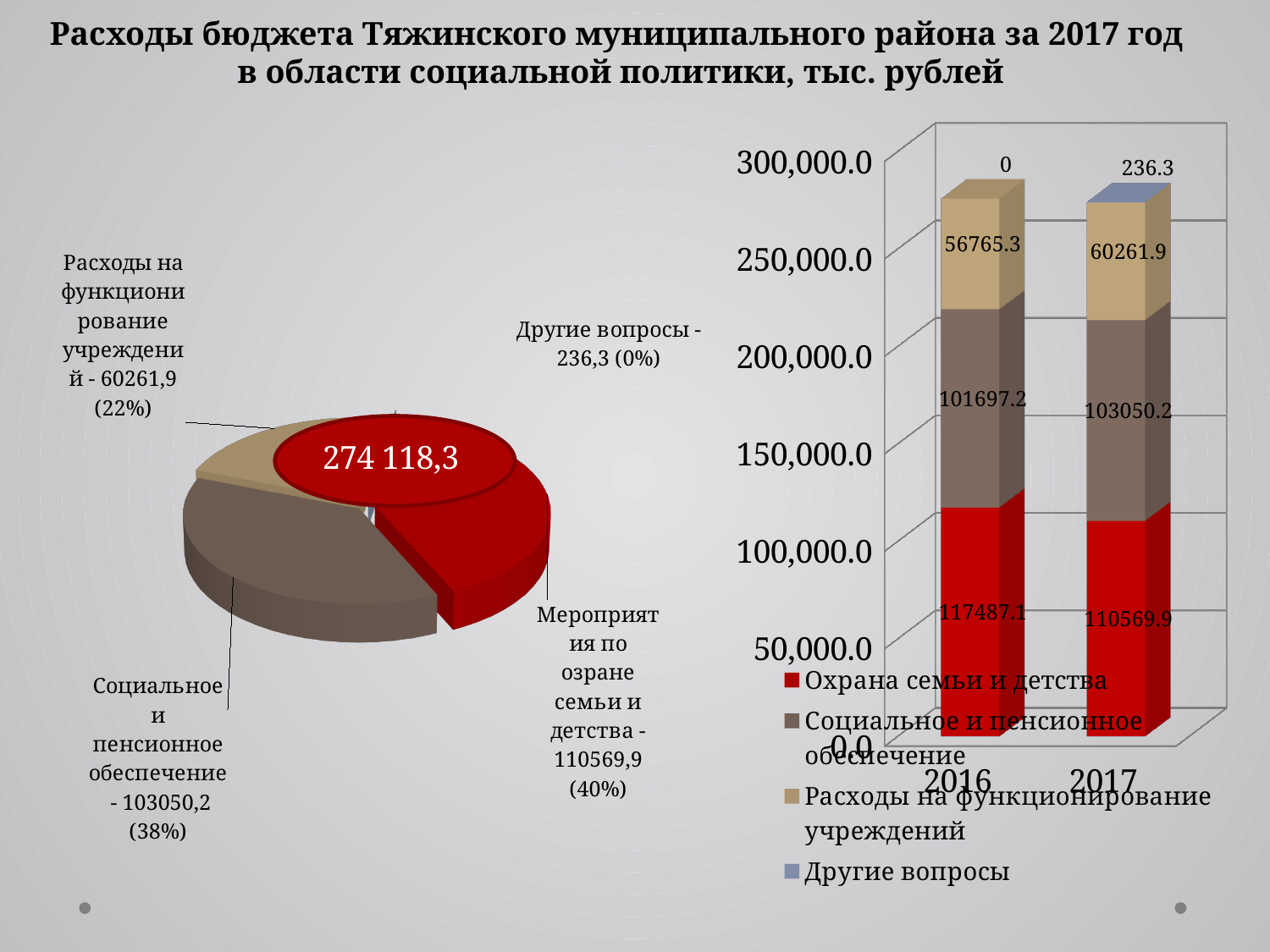
In the stacked bar chart on the right, what is the value of Охрана семьи и детства for 2016? 117487.1 In the stacked bar chart on the right, how many series does the legend list? 4 In the stacked bar chart on the right, what is the total of the stacked bar for 2017? 274118.3 In the stacked bar chart on the right, which year has the larger value for Социальное и пенсионное обеспечение, 2016 or 2017? 2017 In the pie chart on the left, which category has the smallest slice? Другие вопросы What type of chart is the chart on the right side of the slide? stacked bar chart In the stacked bar chart on the right, what is the difference between the Охрана семьи и детства values for 2016 and 2017? 6917.2 What type of chart is the chart on the left side of the slide? pie chart In the pie chart on the left, what value is shown for Мероприятия по охране семьи и детства? 110569,9 In the pie chart on the left, what share of the pie does Социальное и пенсионное обеспечение represent? 38% In the stacked bar chart on the right, what is the value of Расходы на функционирование учреждений for 2017? 60261.9 In the pie chart on the left, what total value is printed in the centre of the pie? 274 118,3